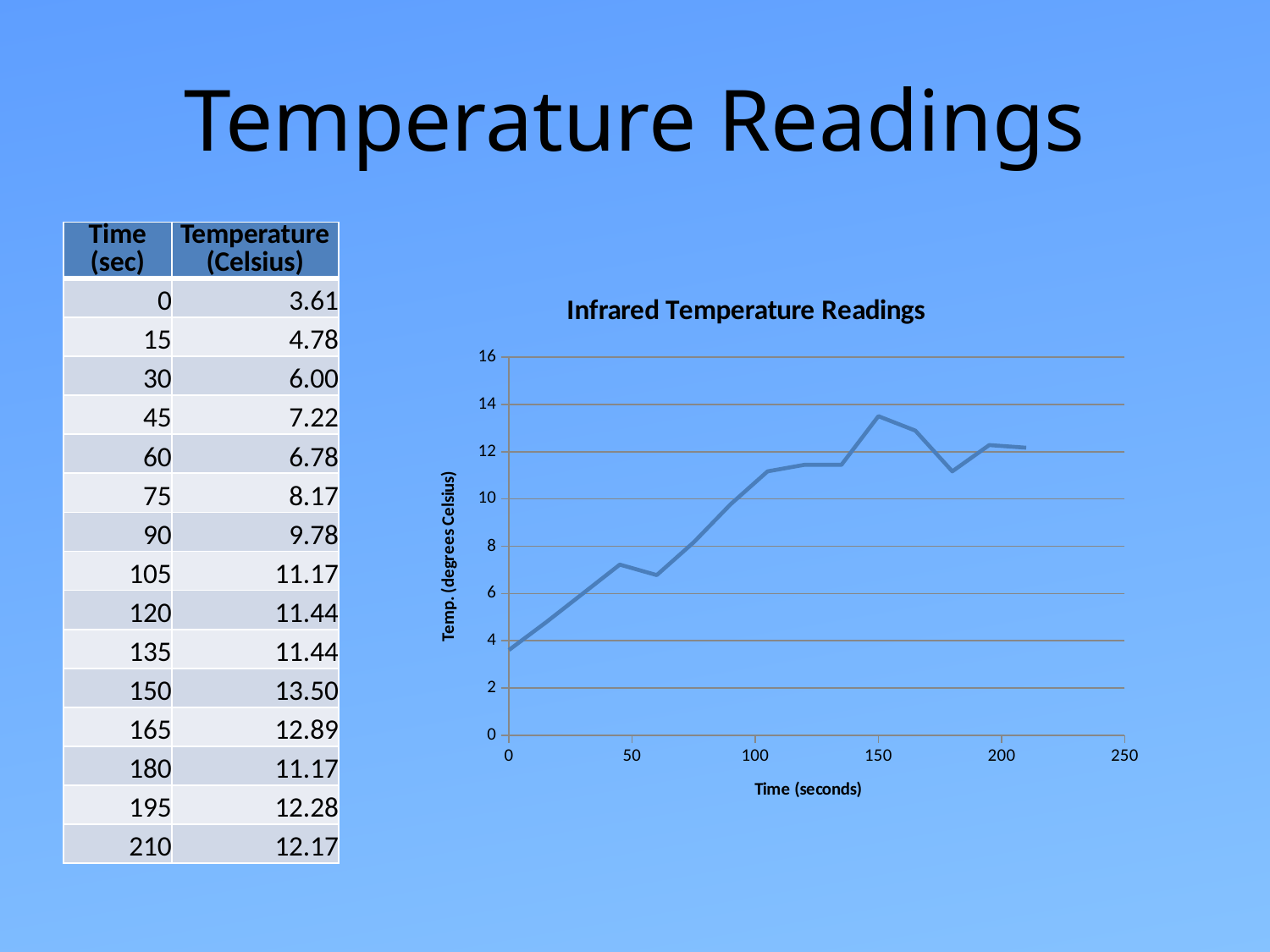
How many data points are plotted on the line chart? 15 At which time (in seconds) is the temperature reading lowest? 0 At which time (in seconds) is the temperature reading highest? 150 Which has the higher temperature reading, 45 seconds or 60 seconds? 45 seconds According to the slide, what is the temperature reading at 150 seconds? 13.50 What is the difference between the temperature readings at 150 seconds and 180 seconds? 2.33 What is the title of the chart? Infrared Temperature Readings What kind of chart is shown on the slide? line chart Overall, does the temperature rise or fall from 0 to 150 seconds? rise What is the label of the x axis of the chart? Time (seconds) According to the slide, what is the temperature reading at 0 seconds? 3.61 Is the temperature reading at 105 seconds greater or less than 10? greater